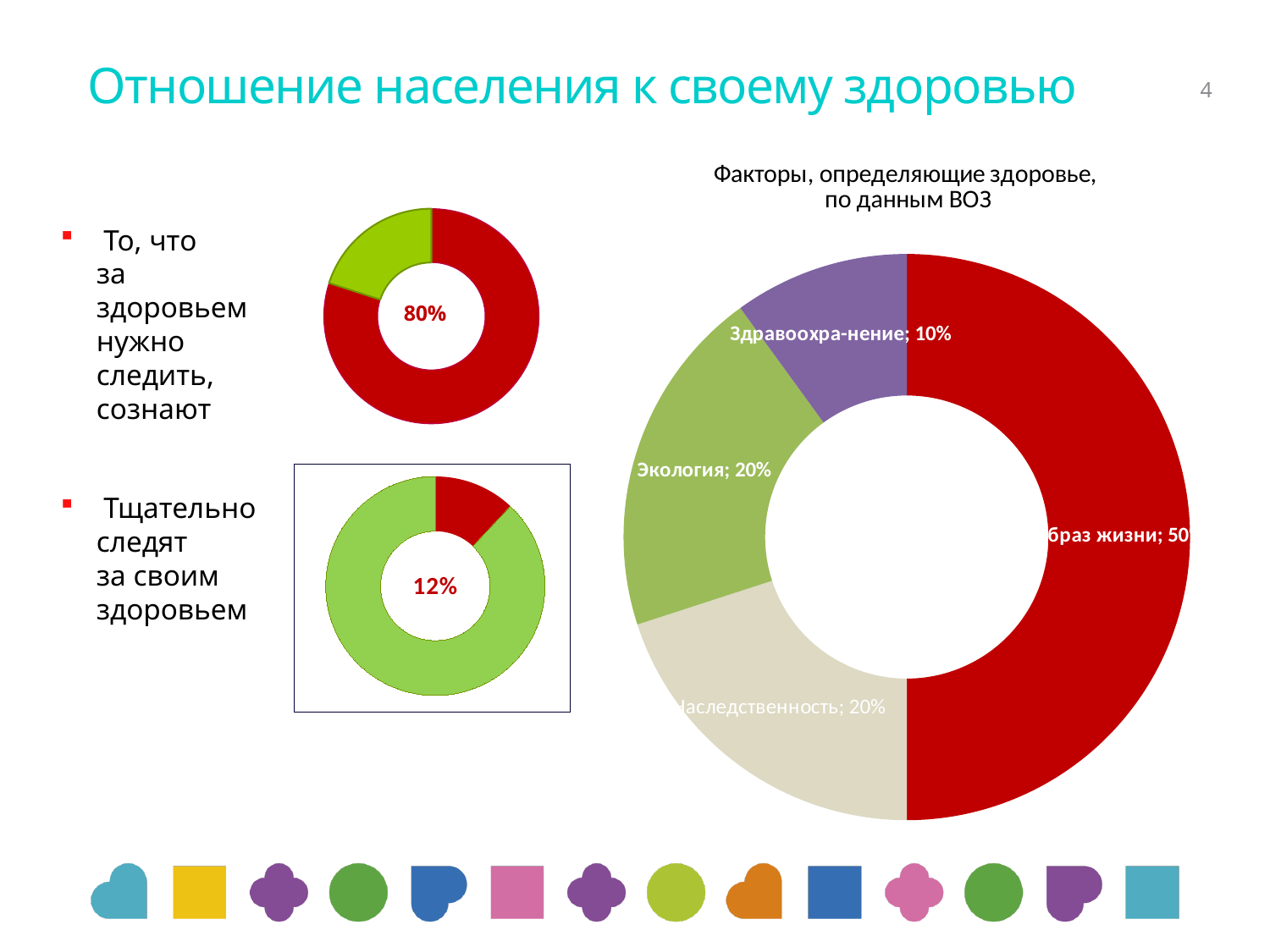
In the chart titled 'Факторы, определяющие здоровье, по данным ВОЗ', how many factors (slices) are shown? 4 In the chart titled 'Факторы, определяющие здоровье, по данным ВОЗ', what is the difference between the values for Экология and Здравоохранение? 10 percentage points What kind of chart is the one titled 'Факторы, определяющие здоровье, по данным ВОЗ'? Doughnut (pie) chart What percentage is shown in the centre of the upper small doughnut chart on the left of the slide (next to 'То, что за здоровьем нужно следить, сознают')? 80% What percentage is shown in the centre of the lower small doughnut chart on the left of the slide (next to 'Тщательно следят за своим здоровьем')? 12% In the chart titled 'Факторы, определяющие здоровье, по данным ВОЗ', which is larger: Экология or Здравоохранение? Экология In the chart titled 'Факторы, определяющие здоровье, по данным ВОЗ', what do Экология and Наследственность add up to? 40% In the chart titled 'Факторы, определяющие здоровье, по данным ВОЗ', which factor has the smallest share? Здравоохранение In the chart titled 'Факторы, определяющие здоровье, по данным ВОЗ', which factor has the largest share? Образ жизни In the chart titled 'Факторы, определяющие здоровье, по данным ВОЗ', what is the value for Экология? 20% In the chart titled 'Факторы, определяющие здоровье, по данным ВОЗ', what is the value for Наследственность? 20% In the chart titled 'Факторы, определяющие здоровье, по данным ВОЗ', what is the value for Здравоохранение? 10%